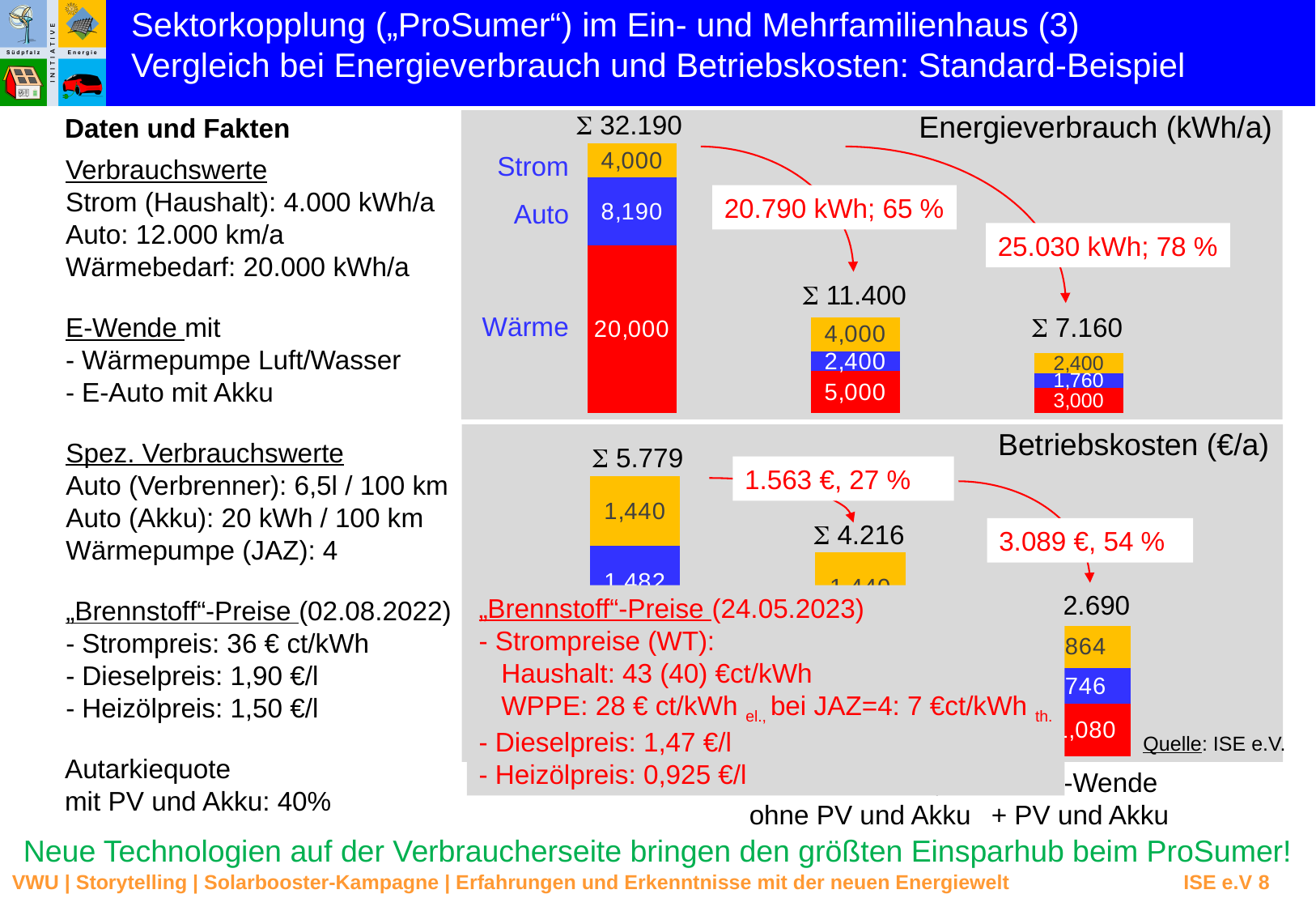
What kind of chart is the Energieverbrauch (kWh/a) chart? stacked bar chart In the Energieverbrauch (kWh/a) chart, what is the total (Σ) of the first (leftmost) bar? 32.190 In the Energieverbrauch (kWh/a) chart, what is the total (Σ) of the third (rightmost) bar? 7.160 In the Energieverbrauch (kWh/a) chart, what is the Auto value of the first (leftmost) bar? 8,190 In the Energieverbrauch (kWh/a) chart, what is the difference between the Wärme value of the first bar and the Wärme value of the second bar? 15,000 In the Betriebskosten (€/a) chart, what is the total (Σ) of the first (leftmost) bar? 5.779 In the Energieverbrauch (kWh/a) chart, is the Strom value or the Auto value of the first bar larger? Auto In the Energieverbrauch (kWh/a) chart, what is the Wärme value of the first (leftmost) bar? 20,000 In the Energieverbrauch (kWh/a) chart, how many series are labelled (Strom, Auto, Wärme)? 3 In the Energieverbrauch (kWh/a) chart, which segment of the first (leftmost) bar is the largest? Wärme In the Betriebskosten (€/a) chart, what is the value of the yellow (top) segment of the third (rightmost) bar? 864 In the Energieverbrauch (kWh/a) chart, what is the Wärme value of the third (rightmost) bar? 3,000